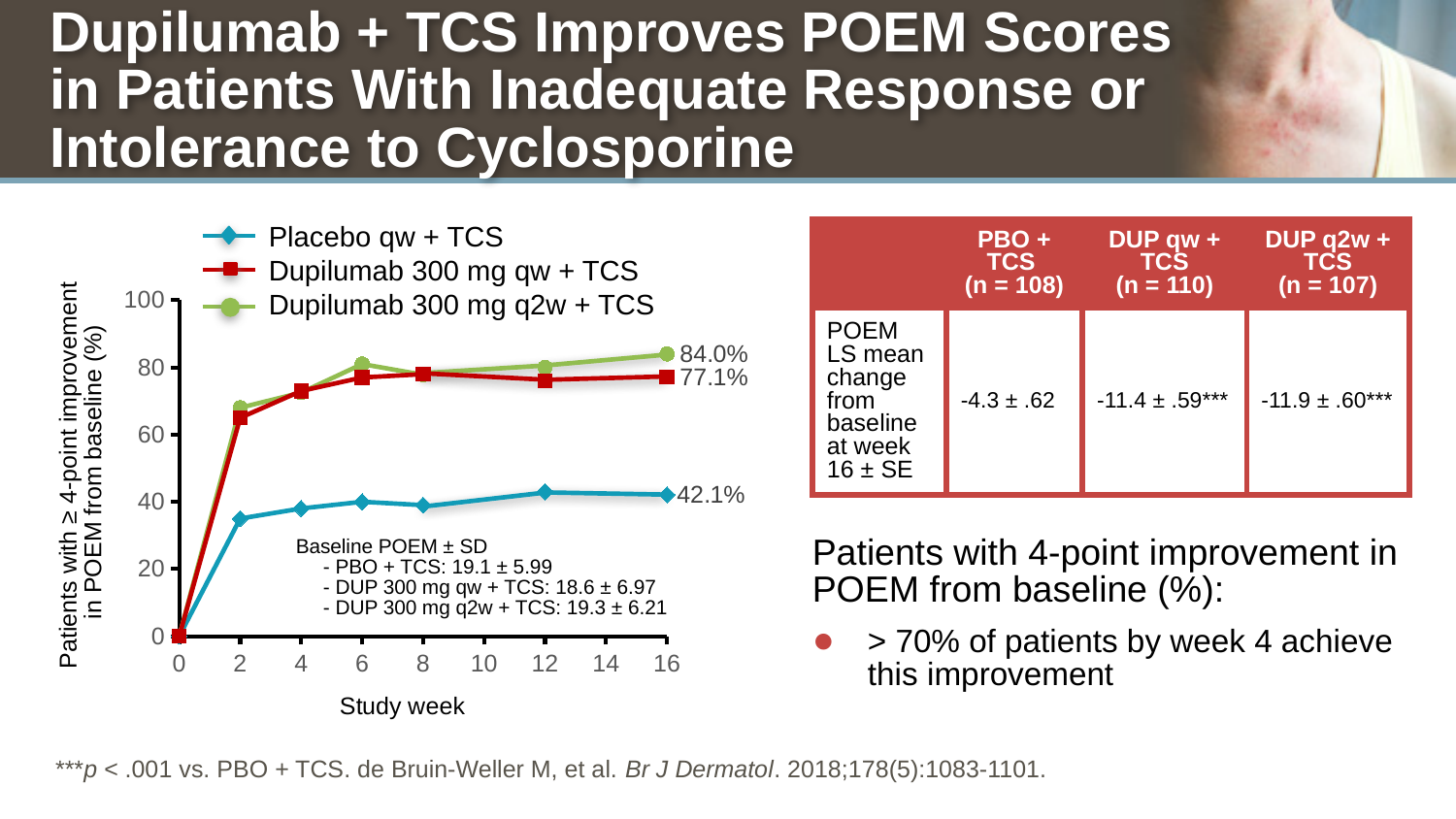
What is the value for Placebo qw + TCS at study week 16? 42.1% How many series does the chart legend list? 3 At week 16, which is larger: Dupilumab 300 mg q2w + TCS or Dupilumab 300 mg qw + TCS? Dupilumab 300 mg q2w + TCS Is the value for Placebo qw + TCS at study week 2 greater or less than 40? less Is the value for Dupilumab 300 mg qw + TCS at study week 2 greater or less than 60? greater Which series has the lowest value at study week 16? Placebo qw + TCS Which series has the highest value at study week 16? Dupilumab 300 mg q2w + TCS What is the value for Dupilumab 300 mg q2w + TCS at study week 16? 84.0% What is the value for Dupilumab 300 mg qw + TCS at study week 16? 77.1% What is the difference between the Dupilumab 300 mg q2w + TCS and Placebo qw + TCS values at week 16? 41.9 percentage points What kind of chart is shown on the slide? Line chart What is the title of the x axis of the chart? Study week